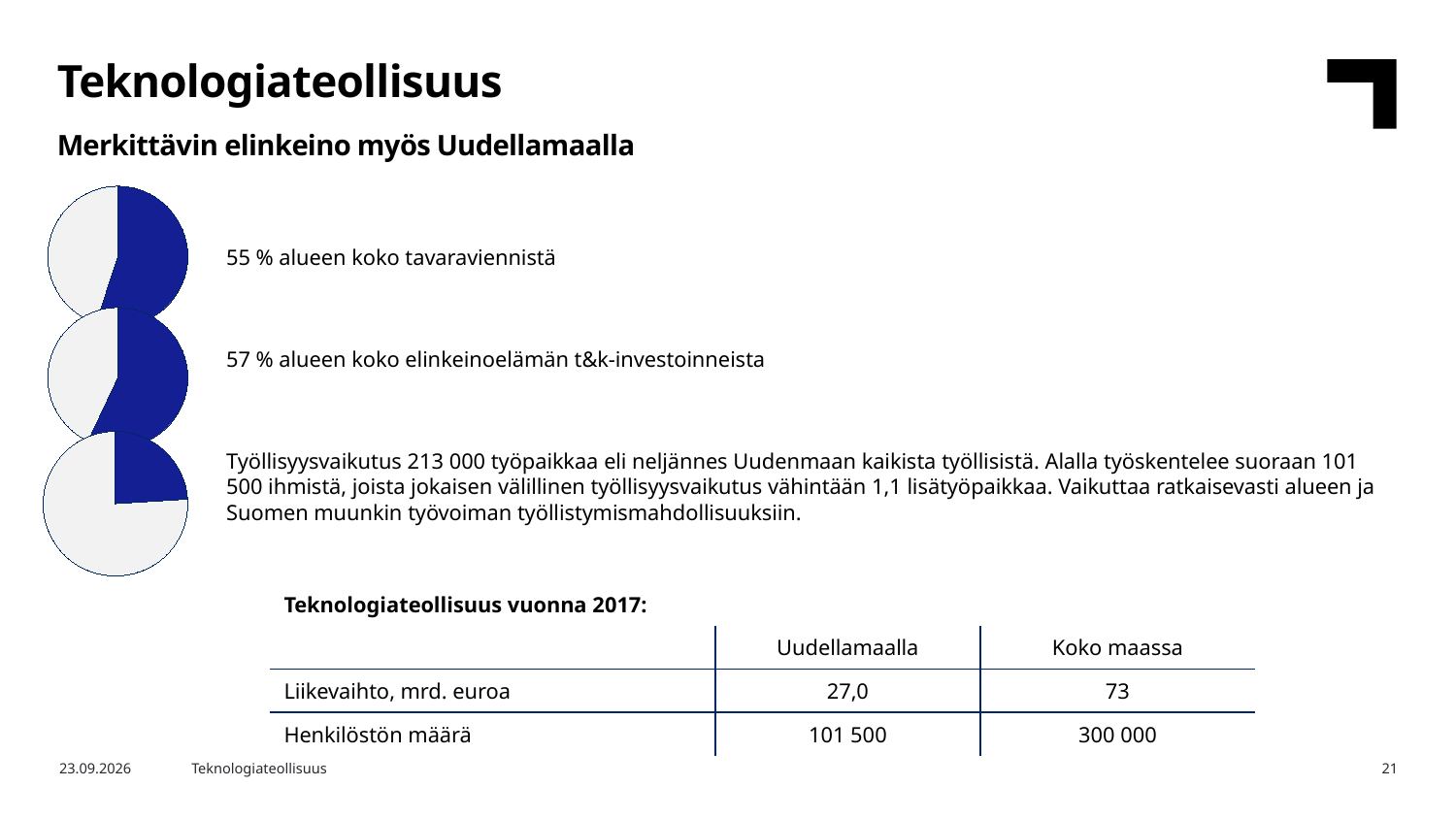
Is the blue slice larger in the middle pie chart or in the top pie chart? middle Which pie chart has the smallest blue slice: the top, middle or bottom one? bottom What does the top pie chart illustrate, according to the text next to it? 55 % alueen koko tavaraviennistä Is the blue slice larger in the top pie chart or in the bottom pie chart? top In the top pie chart, what share does the blue slice represent (share of the region's total goods exports)? 55 % In the middle pie chart, what share does the blue slice represent (share of the region's business R&D investments)? 57 % What is the difference in percentage points between the blue slice of the middle pie chart (57 %) and the blue slice of the top pie chart (55 %)? 2 percentage points How many pie charts are shown on the slide? 3 What kind of chart is the top chart on the left of the slide? pie chart What colour is the highlighted slice in each of the pie charts? blue Which pie chart has the largest blue slice: the top, middle or bottom one? middle